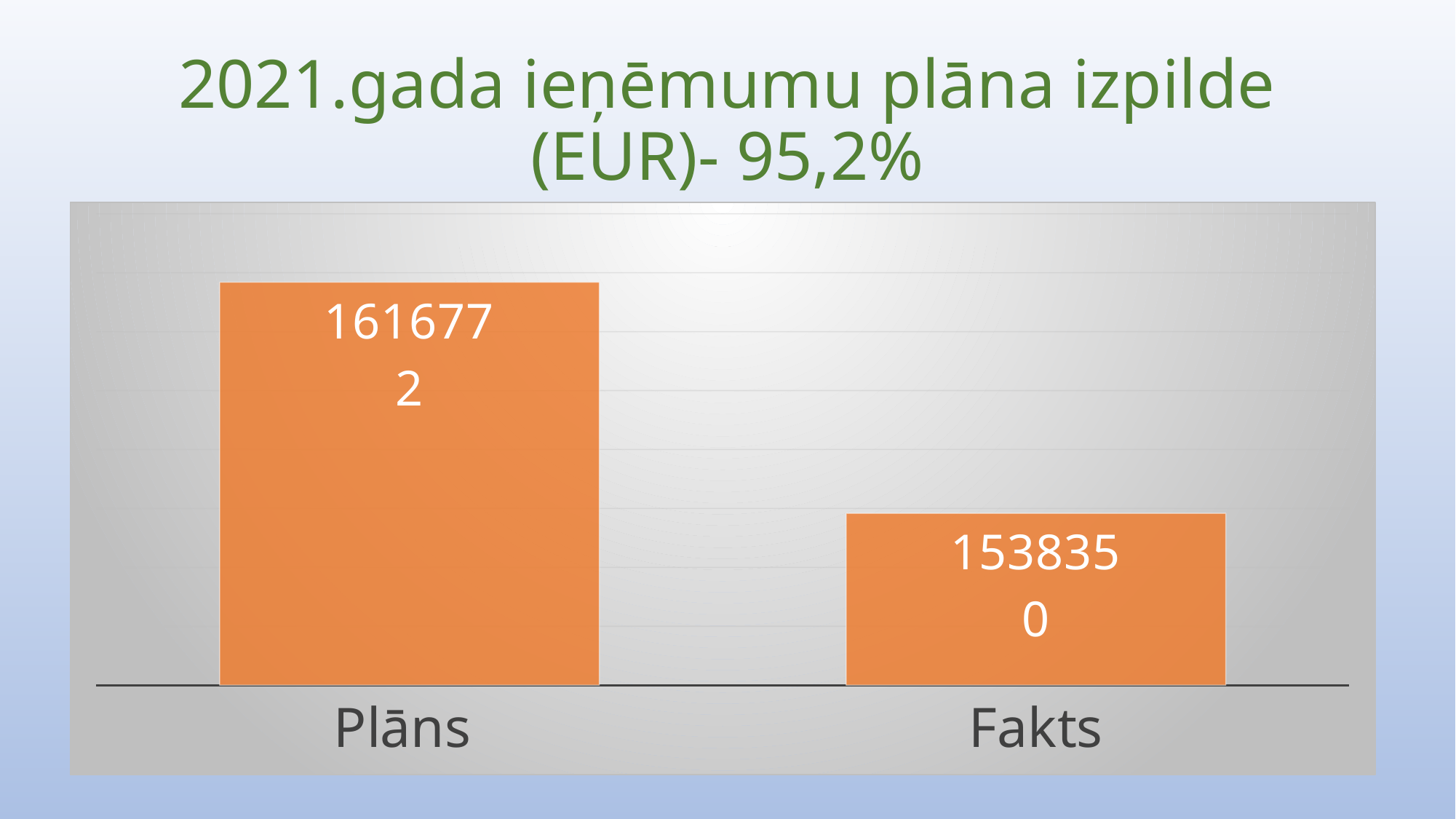
Which is larger, Plāns or Fakts? Plāns What percentage of plan fulfilment is stated in the slide title? 95,2% What is the value of the Plāns bar? 1616772 What is the value of the Fakts bar? 1538350 What is the difference between the Plāns and Fakts values? 78422 Do the values rise or fall from Plāns to Fakts? Fall How many categories are shown in the chart? 2 What colour are the bars in the chart? Orange What kind of chart is shown on the slide? Bar chart Which category has the highest value? Plāns Which category has the lowest value? Fakts